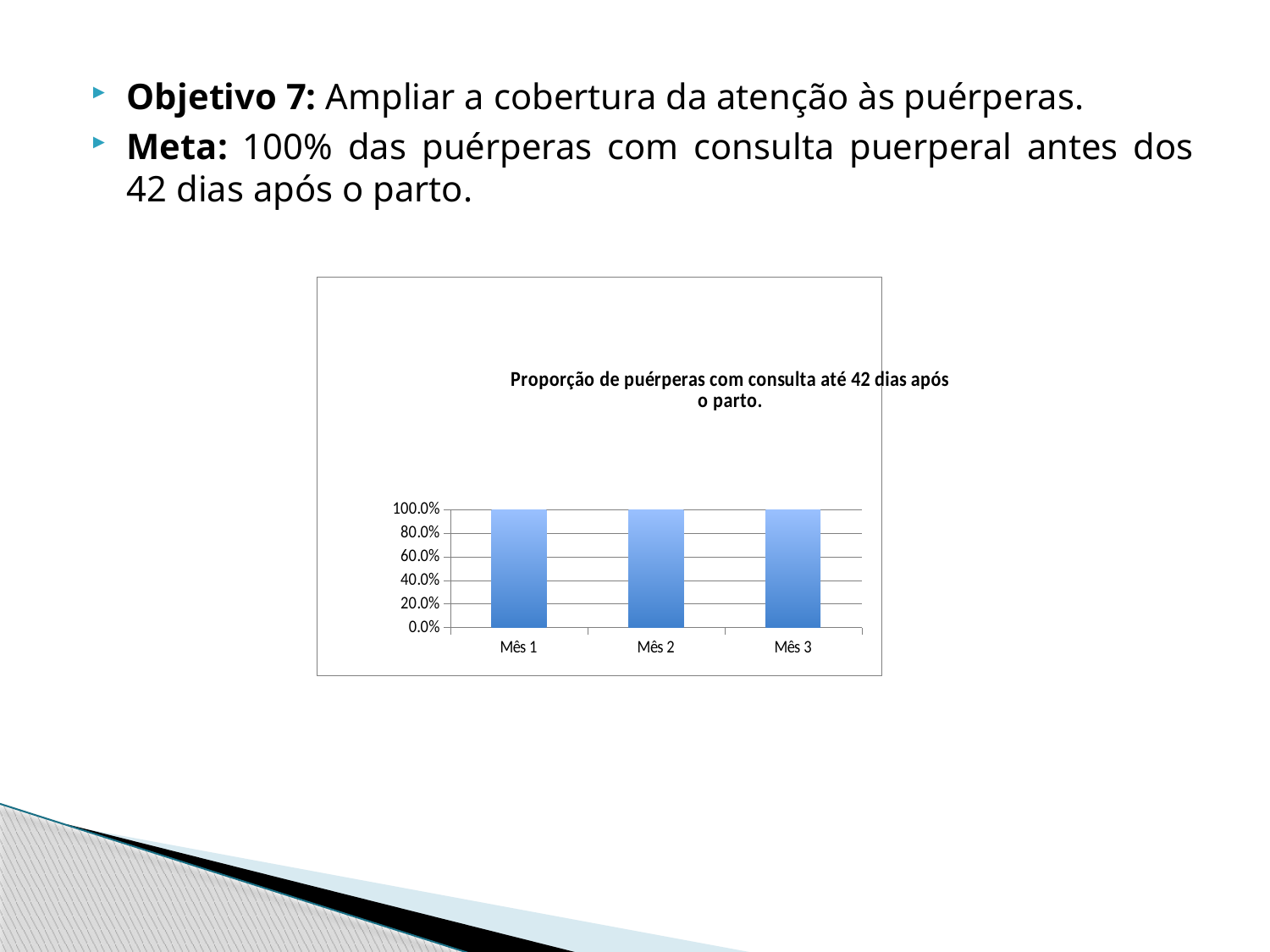
Is the value for Mês 2 greater or less than 80.0%? greater What is the difference between the values for Mês 1 and Mês 3? 0.0% Is the value for Mês 3 greater or less than 60.0%? greater How many categories are plotted on the x axis of the chart? 3 What is the title of the chart? Proporção de puérperas com consulta até 42 dias após o parto. What is the value for Mês 1 in the chart? 100.0% Do the values rise, fall or stay the same from Mês 1 to Mês 3? stay the same What colour are the bars in the chart? blue What kind of chart is shown on the slide? bar chart What is the value for Mês 3 in the chart? 100.0% What is the highest value shown on the y axis of the chart? 100.0% What is the value for Mês 2 in the chart? 100.0%